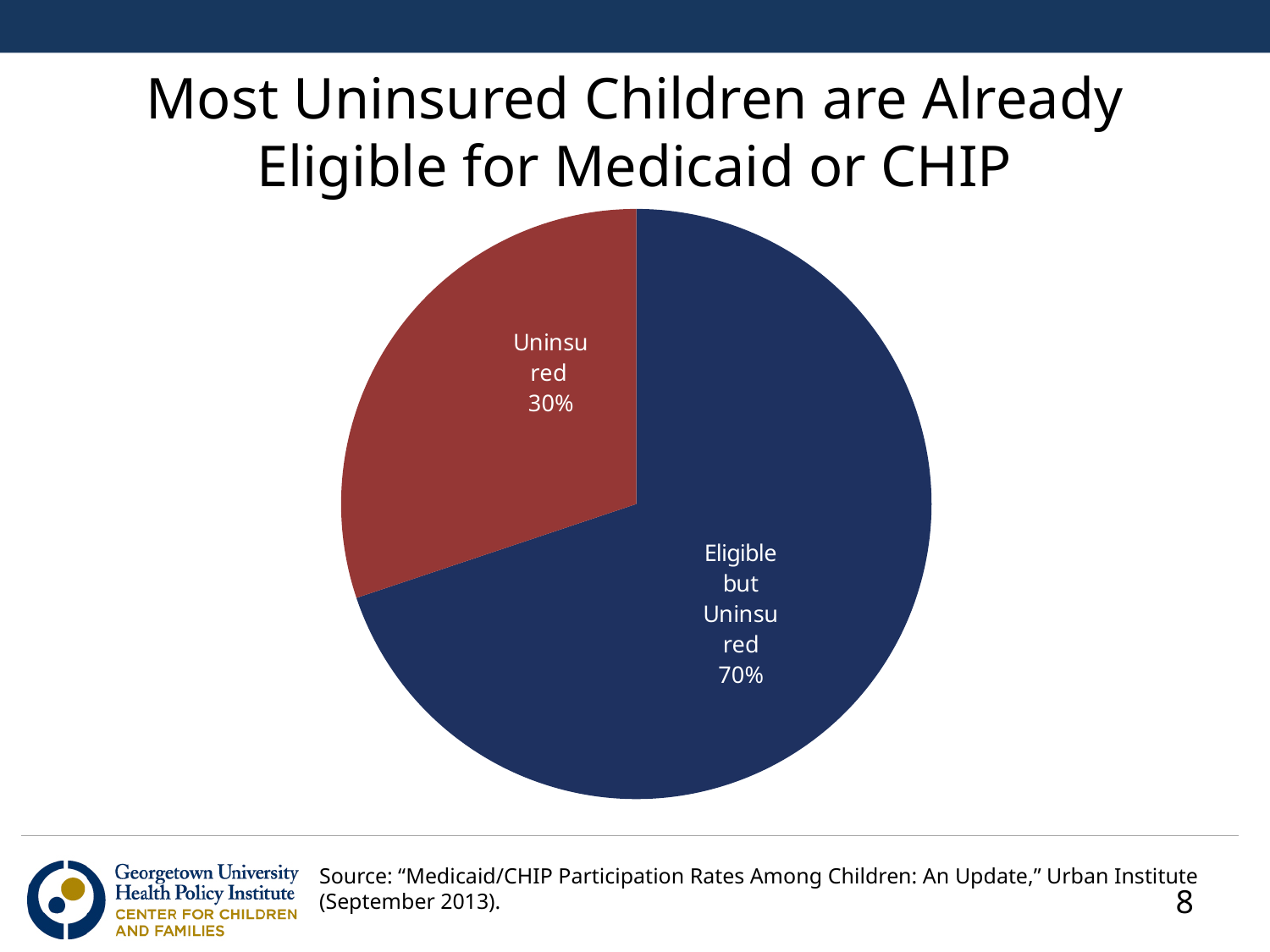
Is the share for "Eligible but Uninsured" greater or less than 50%? greater How many slices does the pie chart have? 2 What is the difference in percentage points between the "Eligible but Uninsured" slice and the "Uninsured" slice? 40 percentage points What is the title of the slide containing the pie chart? Most Uninsured Children are Already Eligible for Medicaid or CHIP Which slice of the pie is the largest? Eligible but Uninsured What share of the pie is labelled "Uninsured"? 30% What colour is the "Uninsured" slice of the pie? Red What kind of chart is shown on the slide? Pie chart Which slice is larger, "Uninsured" or "Eligible but Uninsured"? Eligible but Uninsured Which slice of the pie is the smallest? Uninsured What share of the pie is labelled "Eligible but Uninsured"? 70%